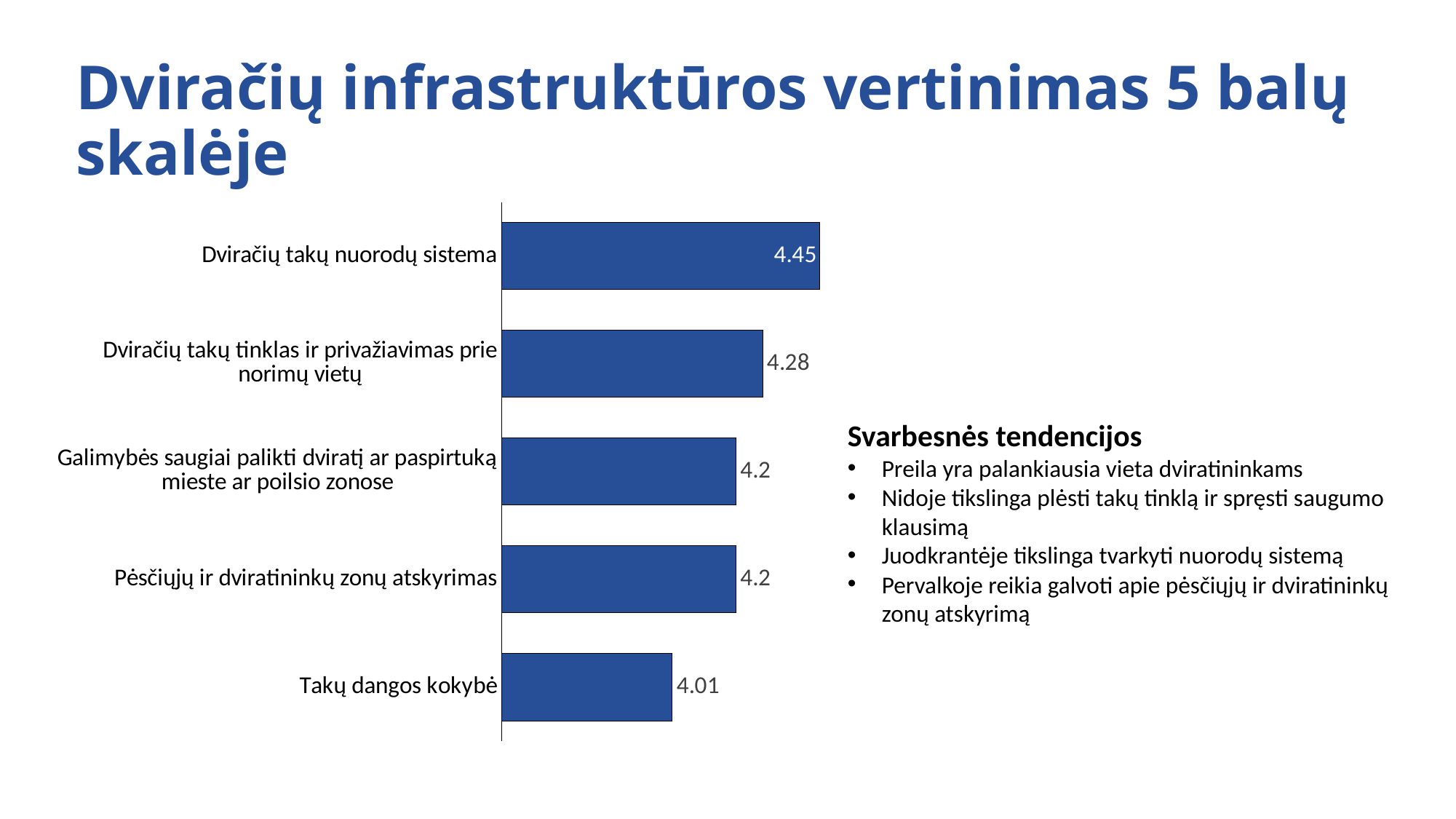
What is the value for "Dviračių takų nuorodų sistema"? 4.45 What is the difference between the values for "Dviračių takų nuorodų sistema" and "Takų dangos kokybė"? 0.44 What is the value for "Dviračių takų tinklas ir privažiavimas prie norimų vietų"? 4.28 What is the title of the slide containing the chart? Dviračių infrastruktūros vertinimas 5 balų skalėje What is the difference between the values for "Dviračių takų tinklas ir privažiavimas prie norimų vietų" and "Galimybės saugiai palikti dviratį ar paspirtuką mieste ar poilsio zonose"? 0.08 What kind of chart is shown on the slide? Bar chart Which category has the lowest value? Takų dangos kokybė What is the value for "Pėsčiųjų ir dviratininkų zonų atskyrimas"? 4.2 How many categories are shown in the chart? 5 Which is larger: the value for "Dviračių takų tinklas ir privažiavimas prie norimų vietų" or the value for "Takų dangos kokybė"? Dviračių takų tinklas ir privažiavimas prie norimų vietų Which category has the highest value? Dviračių takų nuorodų sistema What is the value for "Takų dangos kokybė"? 4.01